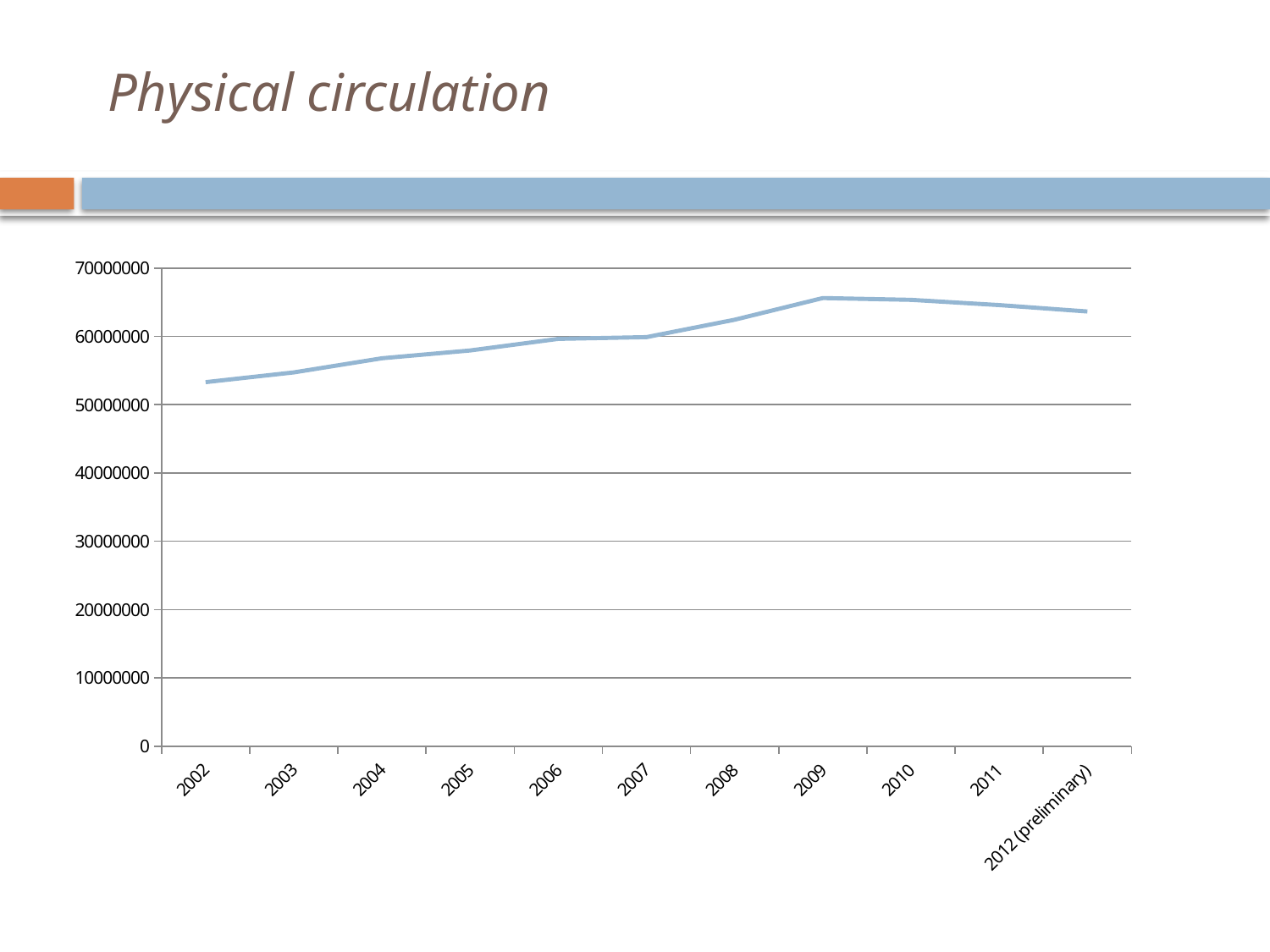
Which is larger, the value for 2012 (preliminary) or the value for 2004? 2012 (preliminary) Is the value for 2002 greater or less than 50000000? greater Is the value for 2002 greater or less than 60000000? less Which is larger, the value for 2009 or the value for 2002? 2009 What is the title of the slide containing the chart? Physical circulation Is the value for 2005 greater or less than 60000000? less How many years (data points) are plotted along the x axis? 11 What kind of chart is shown on the slide? line chart Do the values rise or fall from 2002 to 2009? rise Which year has the lowest physical circulation? 2002